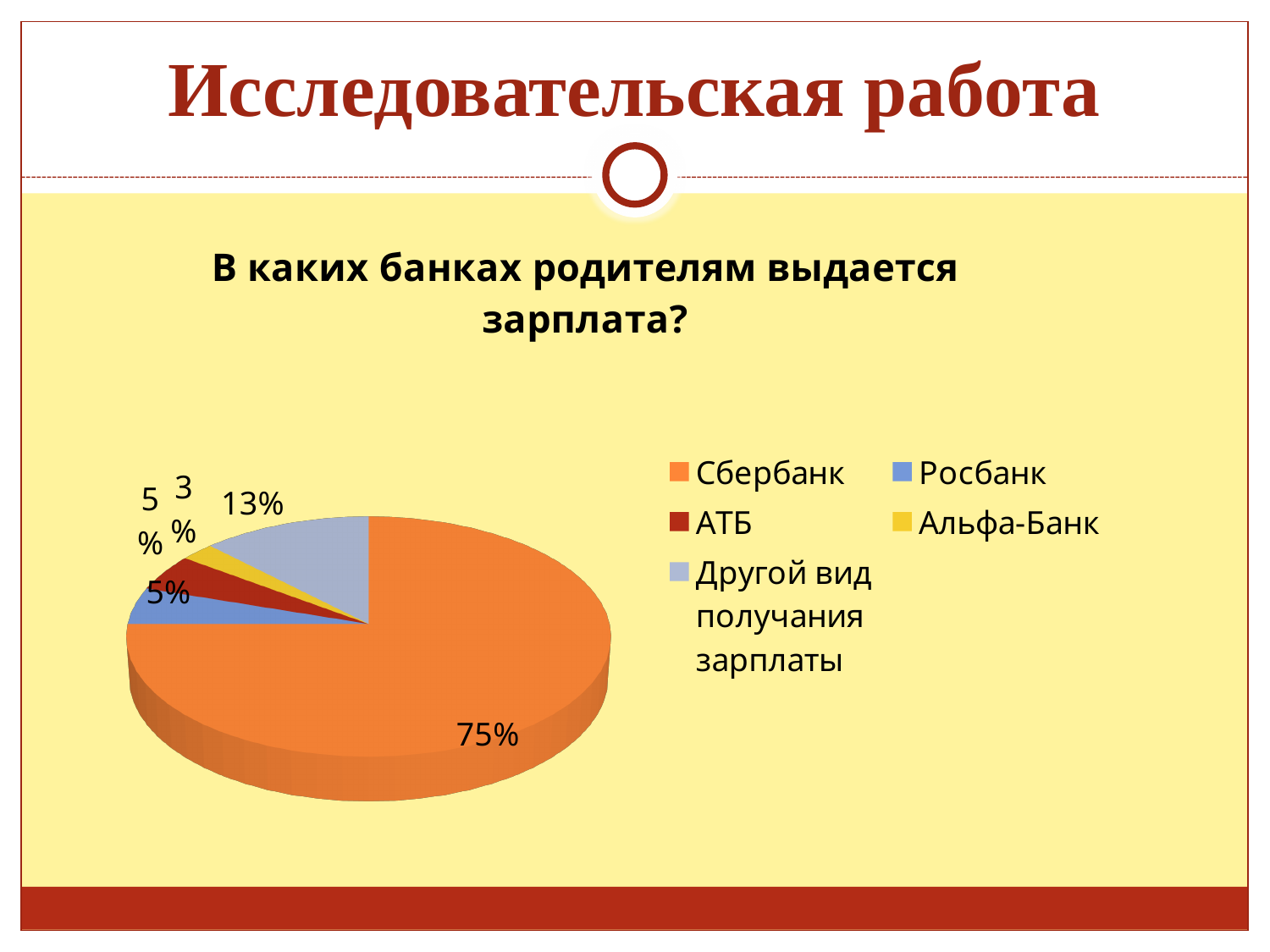
What percentage is shown for Альфа-Банк? 3% What is the title of the chart? В каких банках родителям выдается зарплата? Which category has the smallest slice of the pie? Альфа-Банк By how many percentage points does Сбербанк exceed Другой вид получения зарплаты? 62 percentage points Which is larger: the share for Другой вид получения зарплаты or the share for Росбанк? Другой вид получения зарплаты What percentage is shown for Росбанк? 5% Which category has the largest slice of the pie? Сбербанк What percentage is shown for Другой вид получения зарплаты? 13% What kind of chart is shown on the slide? Pie chart How many categories does the pie chart show? 5 What percentage is shown for АТБ? 5% What share of the pie does Сбербанк hold? 75%